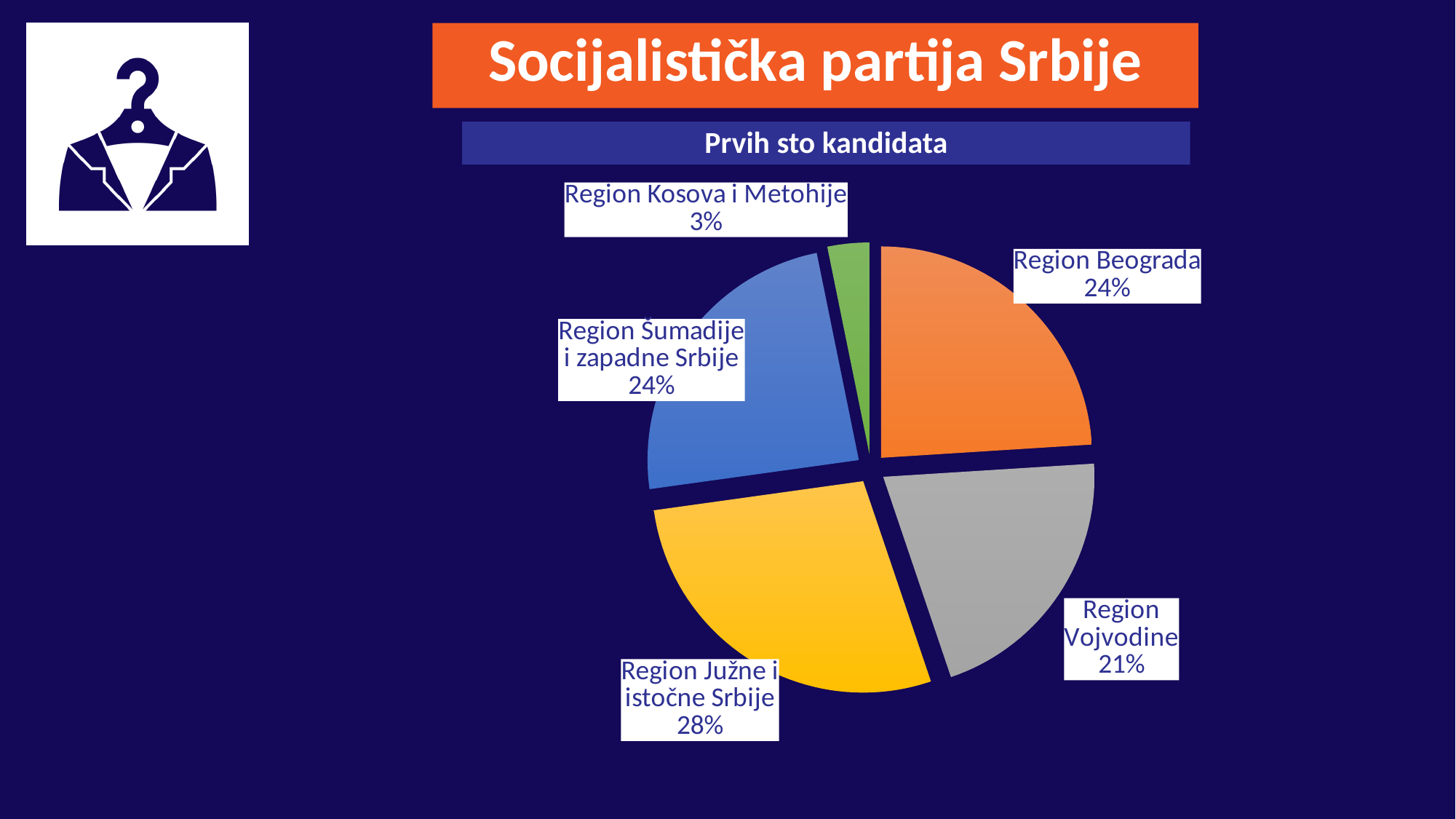
What is the subtitle shown above the pie chart? Prvih sto kandidata What share of the pie does Region Kosova i Metohije have? 3% What is the difference in percentage points between Region Južne i istočne Srbije and Region Vojvodine? 7 What share of the pie does Region Šumadije i zapadne Srbije have? 24% Which is larger, the share for Region Beograda or the share for Region Vojvodine? Region Beograda Which region has the largest slice of the pie? Region Južne i istočne Srbije What share of the pie does Region Beograda have? 24% Which region has the smallest slice of the pie? Region Kosova i Metohije How many slices does the pie chart have? 5 What kind of chart is shown on the slide? pie chart